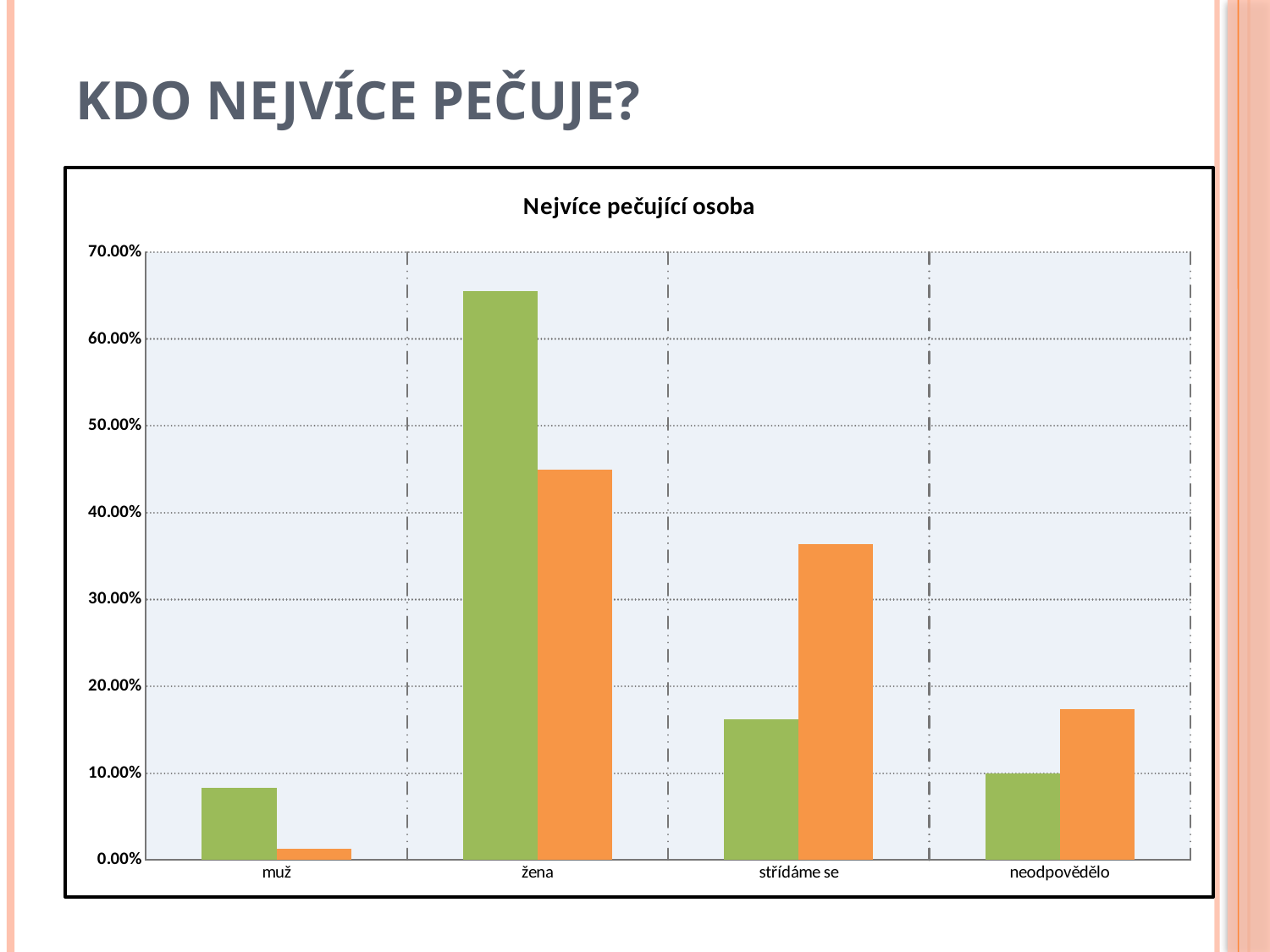
Is the orange bar for žena greater or less than 50.00%? less For the category muž, which bar is taller, the green one or the orange one? green Which category has the tallest orange bar? žena What is the title of the chart? Nejvíce pečující osoba Which category has the shortest green bar? muž Is the green bar for žena greater or less than 60.00%? greater Is the orange bar for střídáme se greater or less than 30.00%? greater Which category has the tallest green bar? žena For the category střídáme se, which bar is taller, the green one or the orange one? orange Which category has the shortest orange bar? muž What kind of chart is shown on the slide? bar chart How many categories are shown on the x axis of the chart? 4